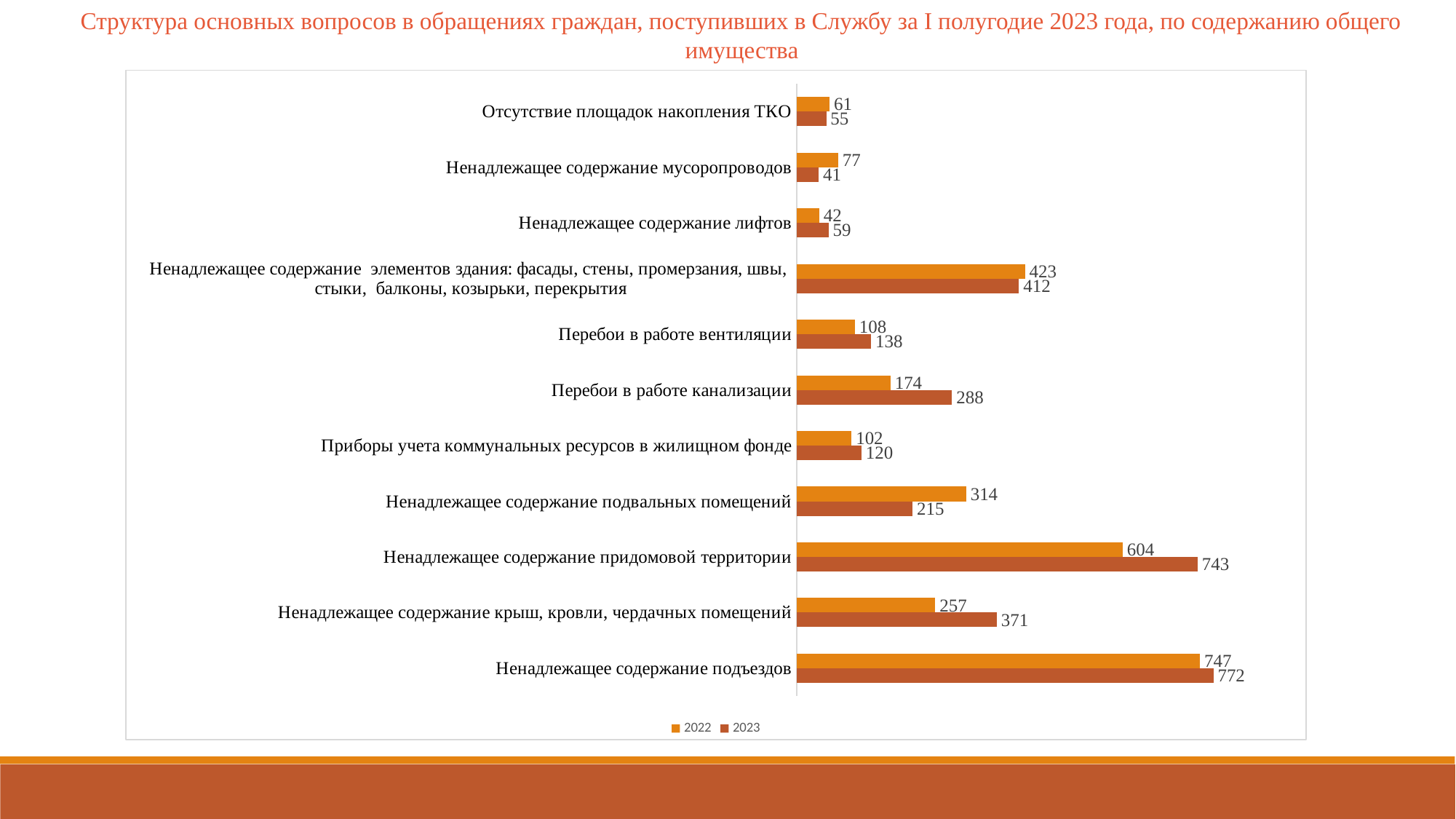
What is the 2022 value for "Перебои в работе канализации"? 174 Which series is shown in the darker red-brown colour? 2023 Which category has the lowest 2022 value? Ненадлежащее содержание лифтов How many series does the legend list? 2 What is the difference between the 2023 and 2022 values for "Ненадлежащее содержание крыш, кровли, чердачных помещений"? 114 For "Ненадлежащее содержание подвальных помещений", which year has the larger value, 2022 or 2023? 2022 What is the 2023 value for "Ненадлежащее содержание придомовой территории"? 743 Which category has the highest 2023 value? Ненадлежащее содержание подъездов How many categories are shown on the chart? 11 What is the 2023 value for "Ненадлежащее содержание лифтов"? 59 Which category has the lowest 2023 value? Ненадлежащее содержание мусоропроводов What kind of chart is shown on the slide? Bar chart